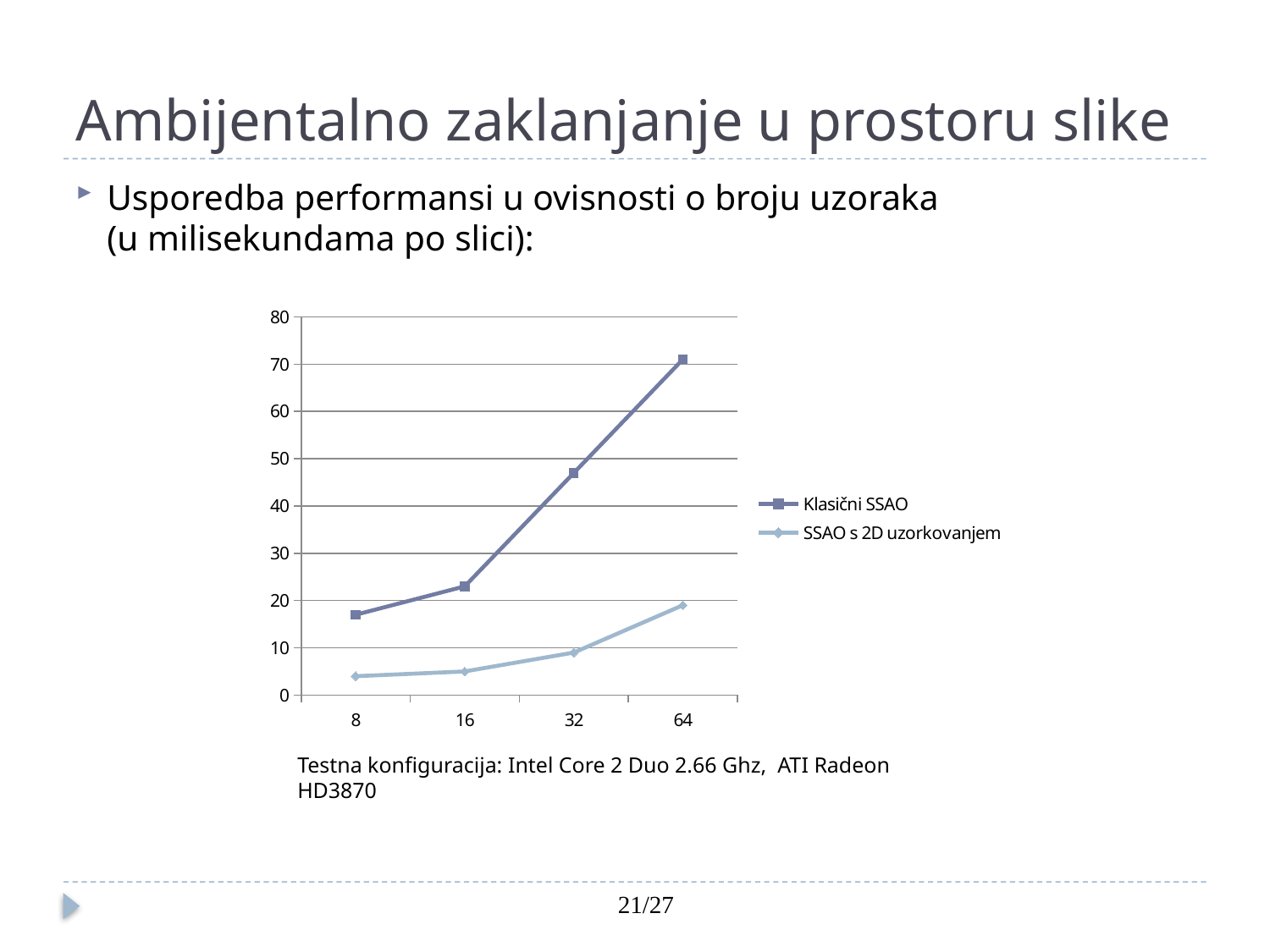
Do the values for Klasični SSAO rise or fall as the number of samples increases from 8 to 64? rise Is the value for Klasični SSAO at 8 greater or less than 20? less How many points are plotted along the x axis for each series? 4 Which series has the highest value at 64 samples? Klasični SSAO Which is larger at 32 samples: Klasični SSAO or SSAO s 2D uzorkovanjem? Klasični SSAO How many series does the legend list? 2 Is the value for Klasični SSAO at 64 greater or less than 60? greater What kind of chart is shown on the slide? line chart Is the value for SSAO s 2D uzorkovanjem at 8 greater or less than 10? less What are the x-axis categories shown on the chart? 8, 16, 32, 64 Which series has the lowest value at 8 samples? SSAO s 2D uzorkovanjem